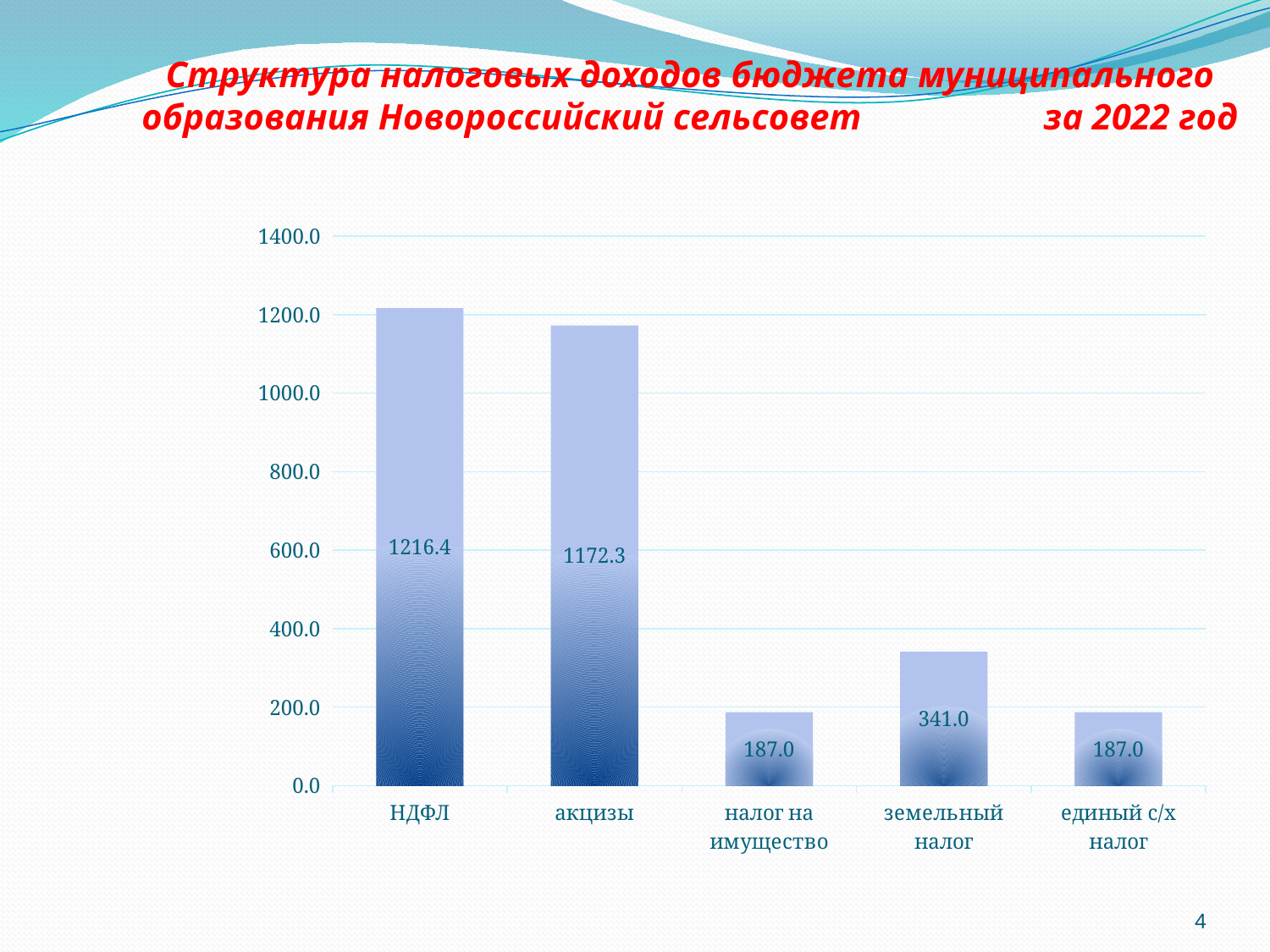
What is the highest value shown on the vertical axis? 1400.0 What is the value for НДФЛ? 1216.4 What is the value for акцизы? 1172.3 Which category has the highest value? НДФЛ How many categories are shown on the x axis? 5 What is the value for земельный налог? 341.0 What kind of chart is shown on the slide? bar chart What is the value for налог на имущество? 187.0 What is the difference between the values for НДФЛ and акцизы? 44.1 What is the difference between the values for земельный налог and единый с/х налог? 154.0 Is the value for акцизы greater or less than 1000.0? greater Which is larger, the value for земельный налог or the value for налог на имущество? земельный налог